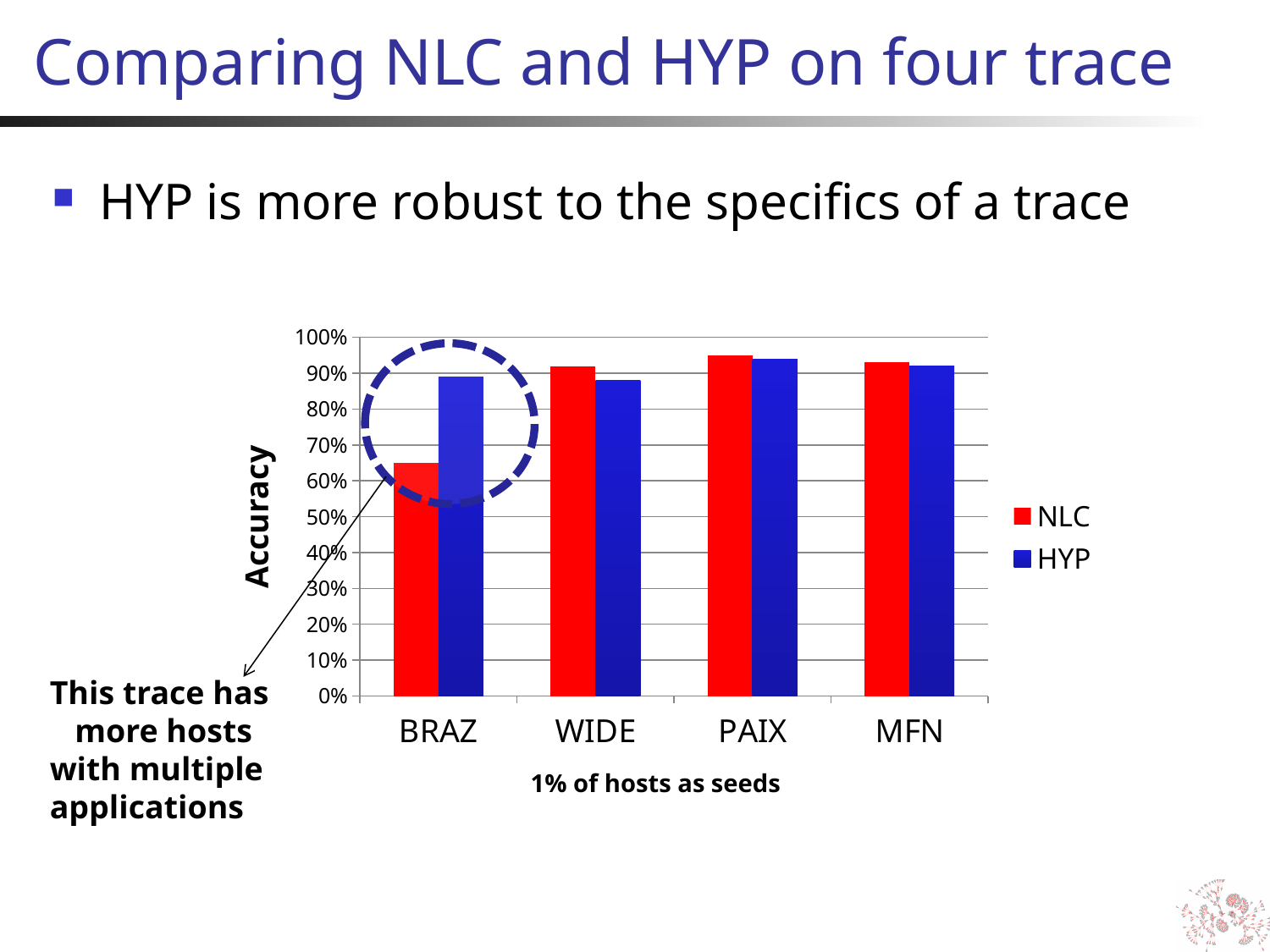
How many series does the chart's legend list? 2 Is the NLC accuracy for BRAZ greater or less than 70%? less For the WIDE trace, which series has the higher accuracy, NLC or HYP? NLC What is the label of the vertical axis of the chart? Accuracy How many traces (categories) are shown on the x axis of the chart? 4 What kind of chart is shown on the slide? bar chart Is the HYP accuracy for WIDE greater or less than 90%? less Is the HYP accuracy for BRAZ greater or less than 80%? greater Which series are listed in the chart's legend? NLC and HYP For the BRAZ trace, which series has the higher accuracy, NLC or HYP? HYP Which trace has the lowest NLC accuracy? BRAZ